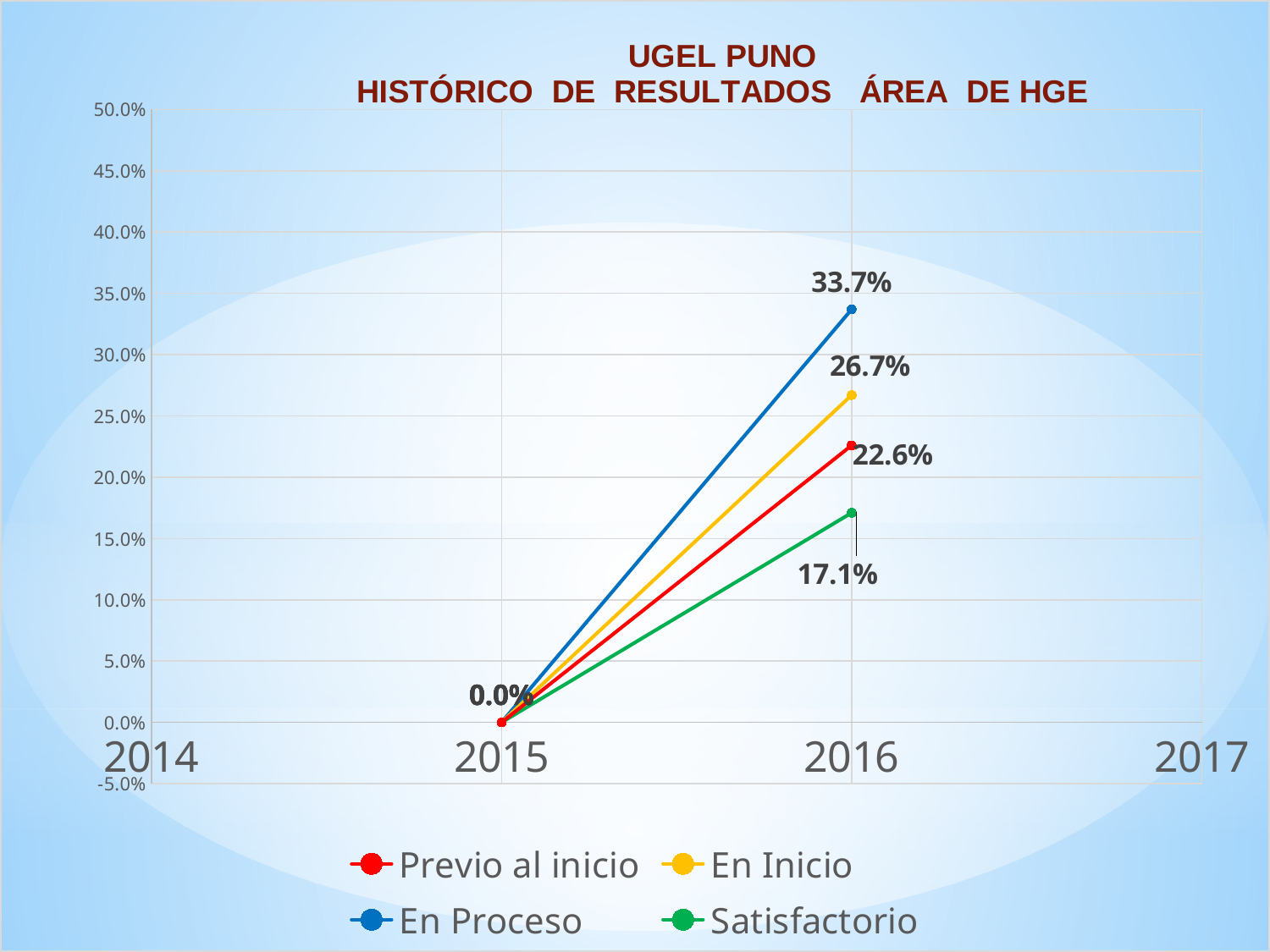
Do the values for En Proceso rise or fall from 2015 to 2016? rise What is the difference between the En Proceso and Satisfactorio values in 2016? 16.6% What is the value for En Proceso in 2016? 33.7% What kind of chart is shown on the slide? line chart Is the value for Satisfactorio in 2016 greater or less than 20.0%? less Which series has the lowest value in 2016? Satisfactorio Which is larger in 2016, En Inicio or Previo al inicio? En Inicio How many series does the legend list? 4 What is the value for Satisfactorio in 2016? 17.1% What is the value for Previo al inicio in 2016? 22.6% Which series has the highest value in 2016? En Proceso What is the value for En Inicio in 2016? 26.7%